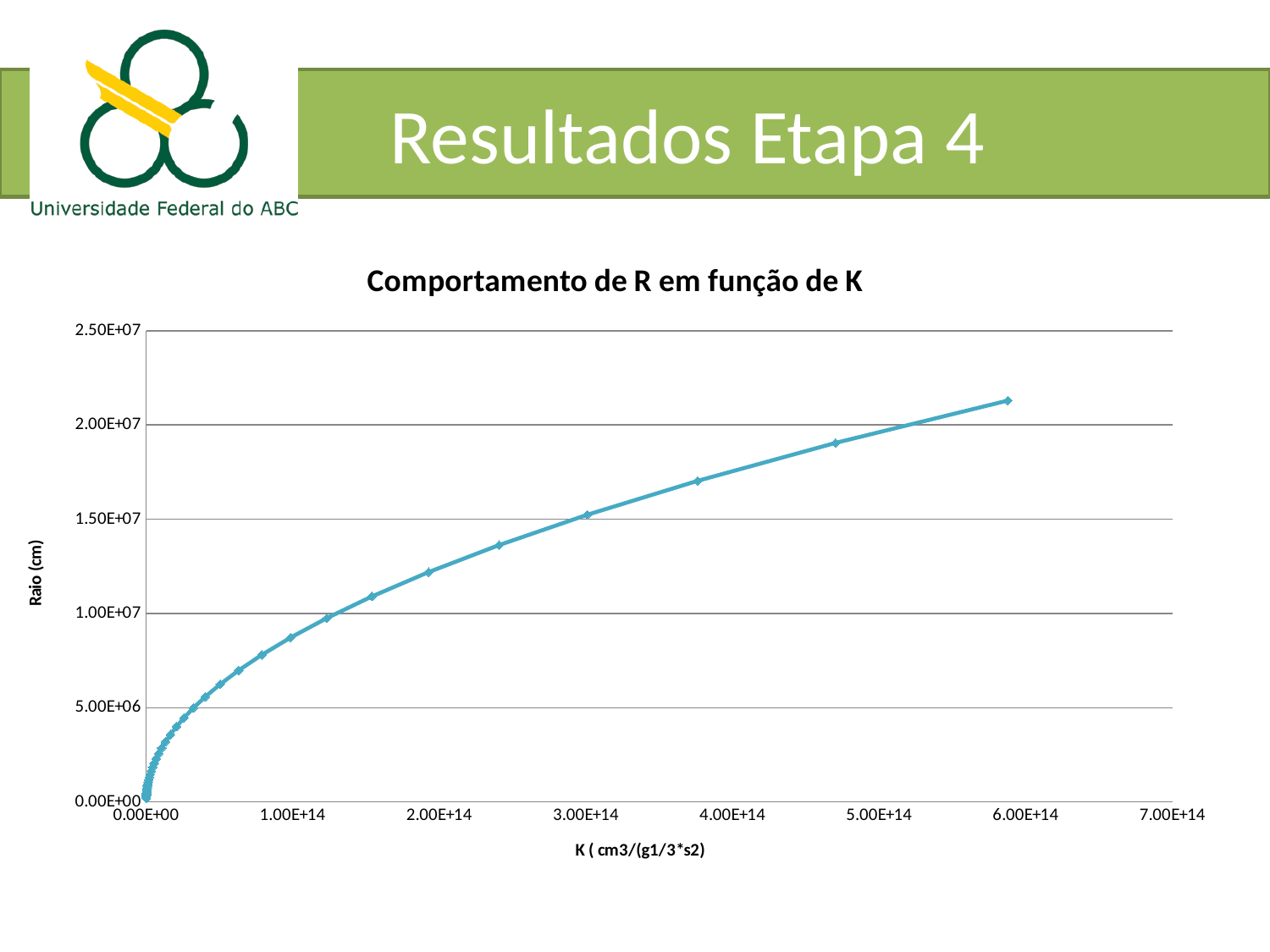
Does Raio rise or fall as K increases along the x axis? rise Is the value of Raio at K = 2.00E+14 greater or less than 1.00E+07? greater Is the value of Raio at K = 5.00E+13 greater or less than 1.00E+07? less What is the title of the chart? Comportamento de R em função de K Is the value of Raio at K = 4.00E+14 greater or less than 2.00E+07? less What kind of chart is shown on the slide? line chart What is the label of the vertical axis? Raio (cm)